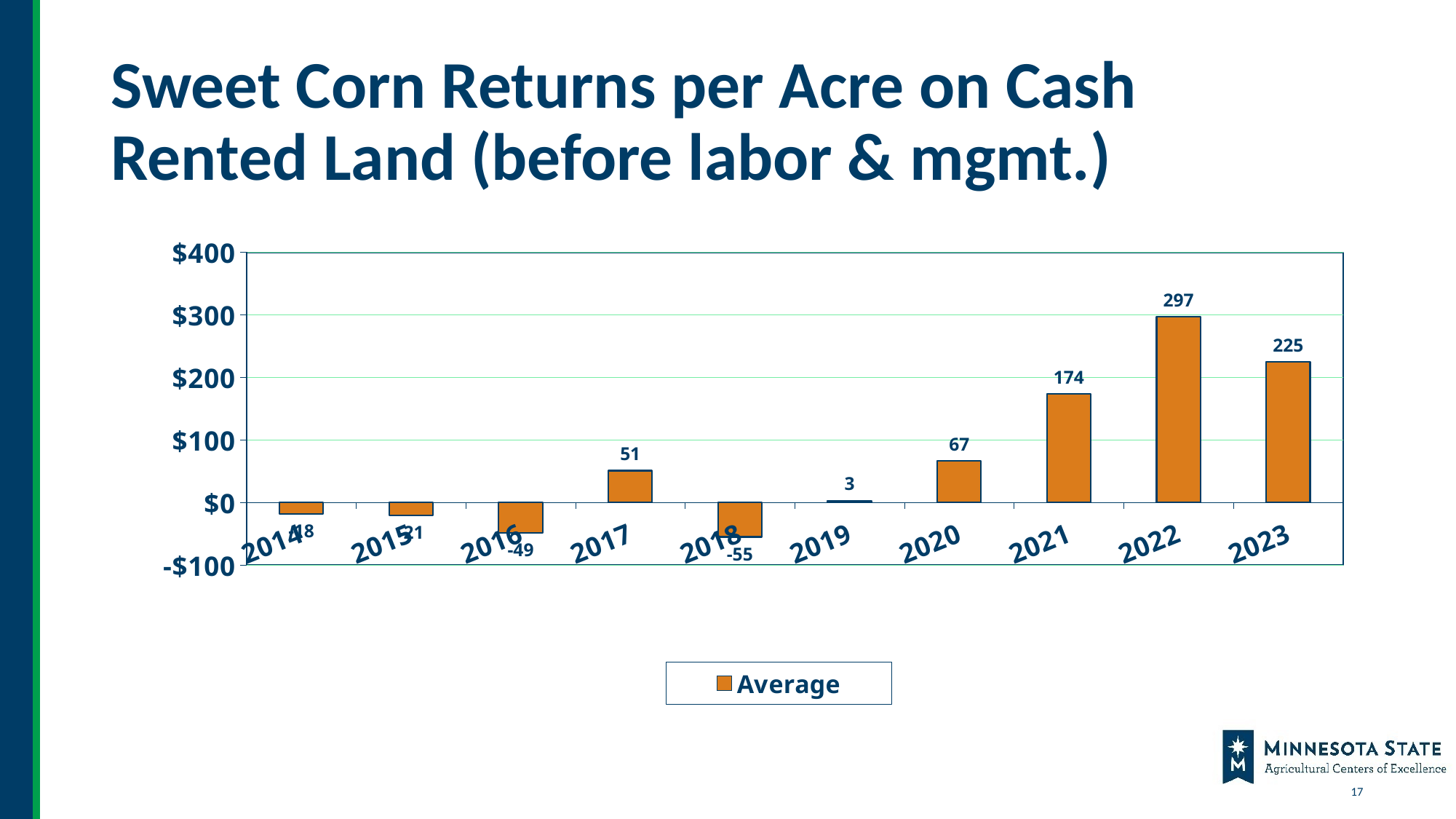
What is the value for 2022? 297 How many years are shown on the x axis? 10 How many series does the legend list? 1 What is the value for 2019? 3 Which year has the highest value? 2022 What is the value for 2021? 174 Is the value for 2021 greater or less than $100? greater What is the value for 2018? -55 Which year has the lowest value? 2018 What is the difference between the values for 2022 and 2023? 72 Which is larger, the value for 2021 or the value for 2023? 2023 What kind of chart is shown? bar chart